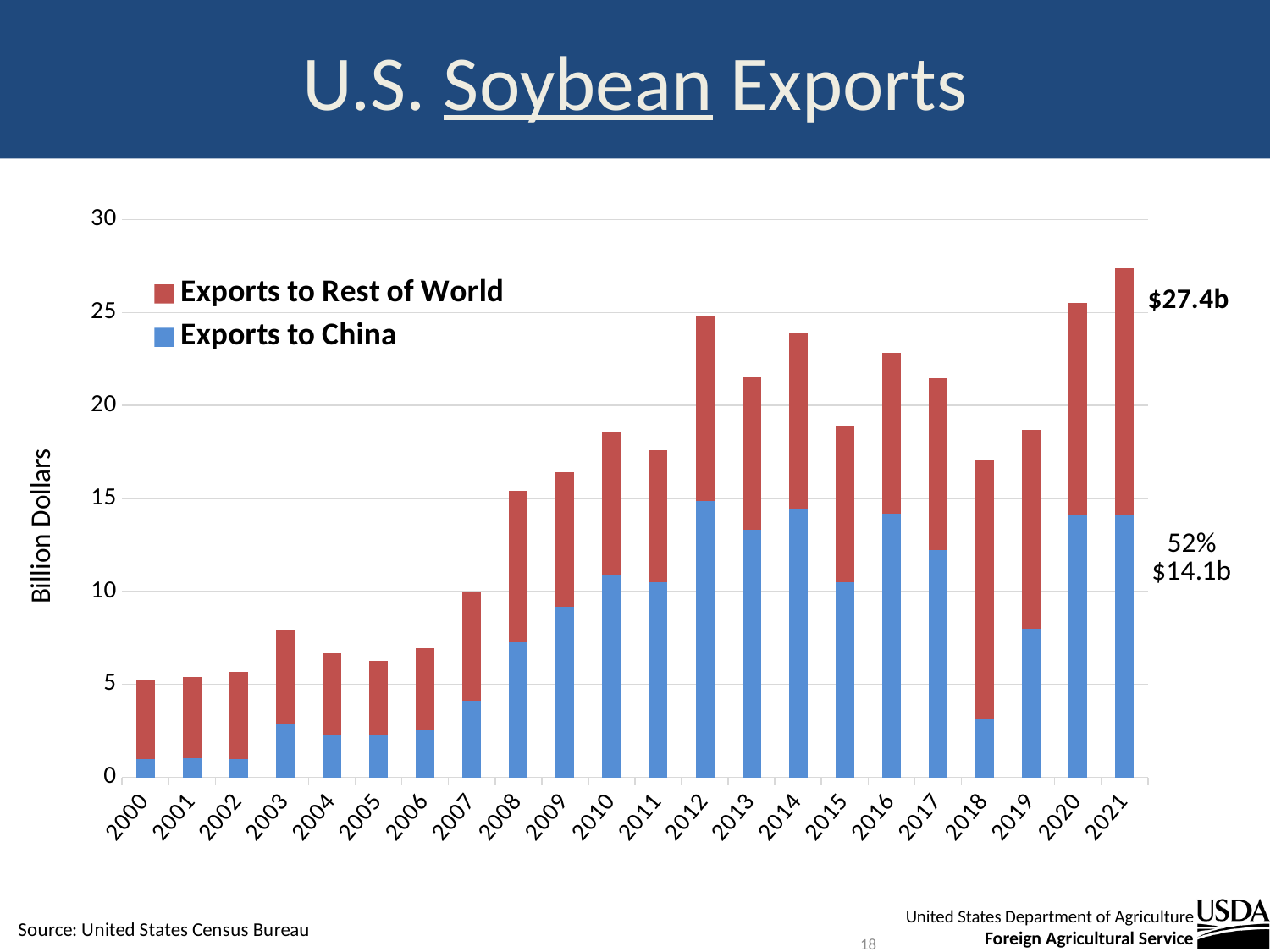
What is the label on the y axis? Billion Dollars What was the value of U.S. soybean exports to China in 2021? $14.1b Based on the labelled values, what was the value of 2021 soybean exports to the rest of the world? $13.3b Which year has the highest total soybean exports? 2021 How many years are shown on the x axis? 22 Is the total value for 2018 greater or less than 20 billion dollars? less How many series does the legend list? 2 Which year had larger total soybean exports, 2012 or 2018? 2012 What kind of chart is shown on the slide? Stacked bar chart What share of U.S. soybean exports went to China in 2021? 52% Is the value of exports to China in 2018 greater or less than 5 billion dollars? less What was the total value of U.S. soybean exports in 2021? $27.4b